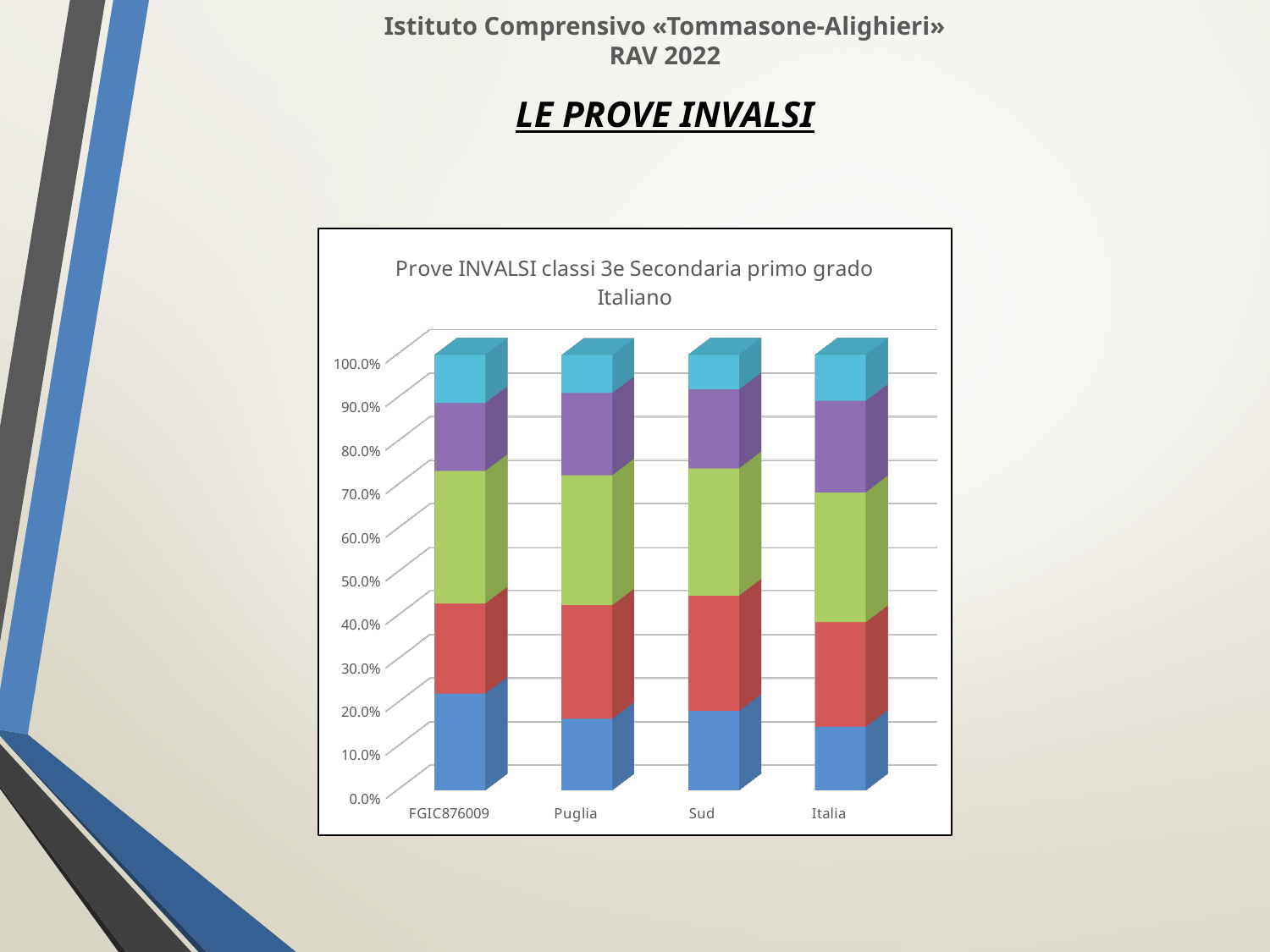
Is the bottom (blue) segment larger for FGIC876009 or for Italia? FGIC876009 Which category is plotted first (leftmost) on the x axis? FGIC876009 Is the bottom (blue) segment for Italia greater or less than 30.0%? less Which category has the largest bottom (blue) segment? FGIC876009 What kind of chart is shown on the slide? Stacked bar chart What is the highest value labelled on the vertical axis? 100.0% Is the bottom (blue) segment for Italia greater or less than 10.0%? greater How many categories are shown on the x axis of the chart? 4 How many coloured segments make up each stacked bar? 5 What is the title of the chart? Prove INVALSI classi 3e Secondaria primo grado Italiano Is the bottom (blue) segment for FGIC876009 greater or less than 20.0%? greater